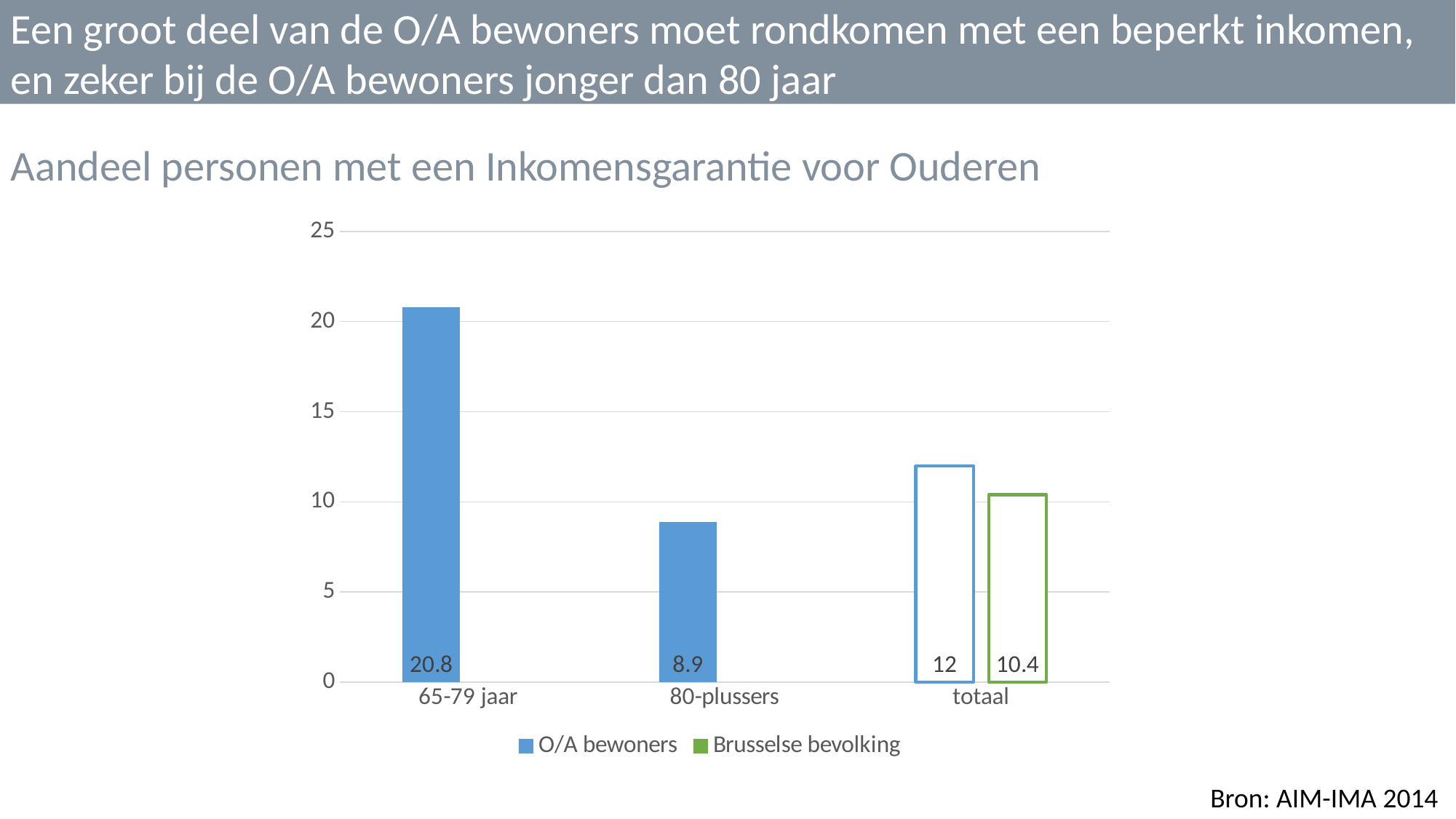
What is the value for O/A bewoners in the totaal category? 12 How many series does the legend list? 2 What is the value for Brusselse bevolking in the totaal category? 10.4 What is the value for O/A bewoners in the 65-79 jaar category? 20.8 What is the value for O/A bewoners in the 80-plussers category? 8.9 Is the value for O/A bewoners in the 65-79 jaar category greater or less than 20? greater Which category has the highest value for O/A bewoners? 65-79 jaar What is the difference between the O/A bewoners values for 65-79 jaar and 80-plussers? 11.9 How many categories are shown on the x axis? 3 In the totaal category, which is larger: O/A bewoners or Brusselse bevolking? O/A bewoners Which category has the lowest value for O/A bewoners? 80-plussers What kind of chart is shown on the slide? bar chart